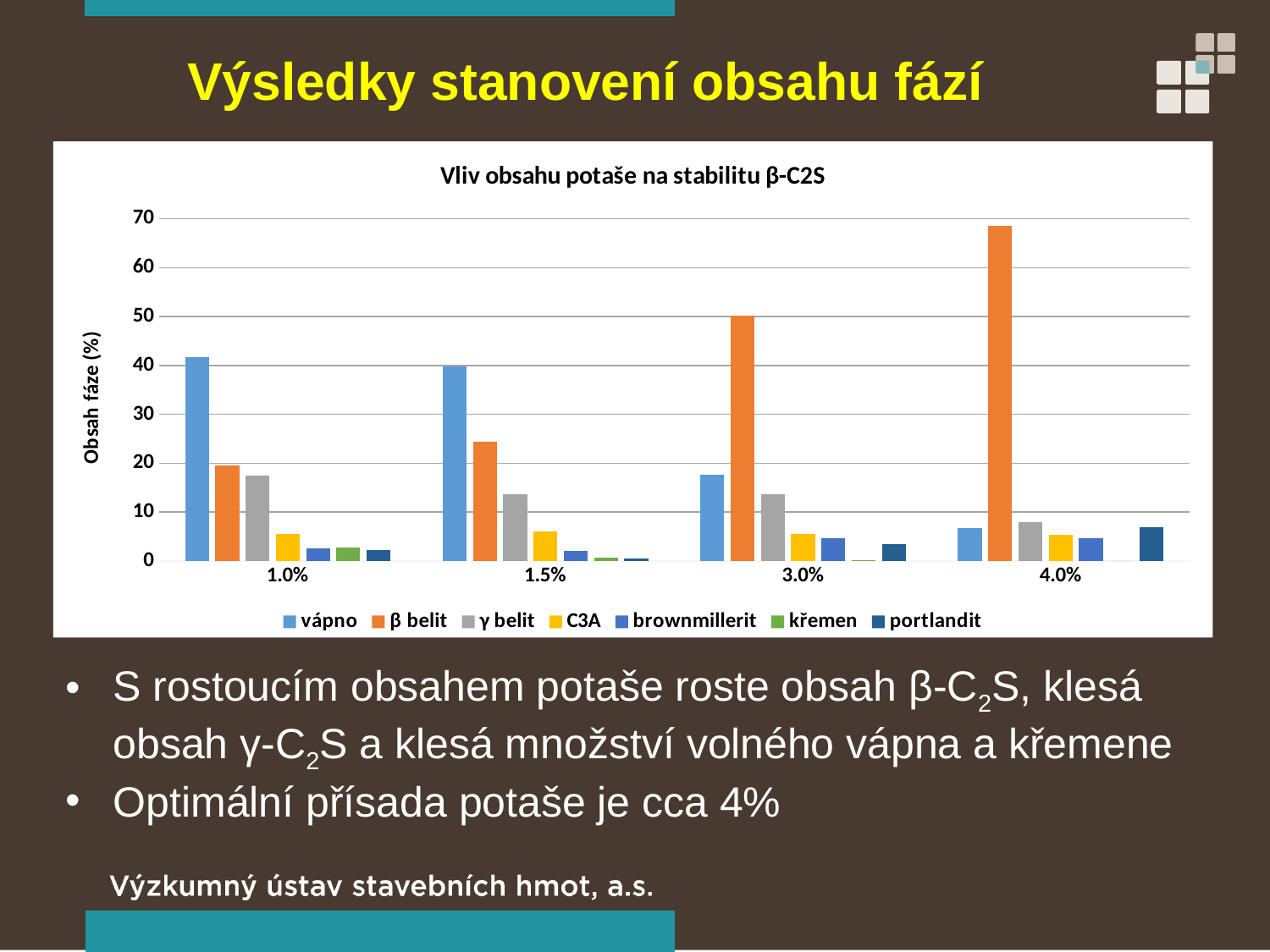
Is the value for β belit at 4.0% greater or less than 60? greater At which potash content is the vápno bar lowest? 4.0% Does the β belit value rise or fall as the potash content increases from 1.0% to 4.0%? rise How many series does the legend list? 7 What is the label of the vertical axis? Obsah fáze (%) Is the value for β belit at 3.0% greater or less than 40? greater At which potash content is the β belit bar highest? 4.0% Is the value for vápno at 1.0% greater or less than 40? greater At 3.0% potash, which is larger: vápno or β belit? β belit What is the title of the chart? Vliv obsahu potaše na stabilitu β-C2S How many potash content categories are shown on the x axis? 4 What kind of chart is shown on the slide? bar chart